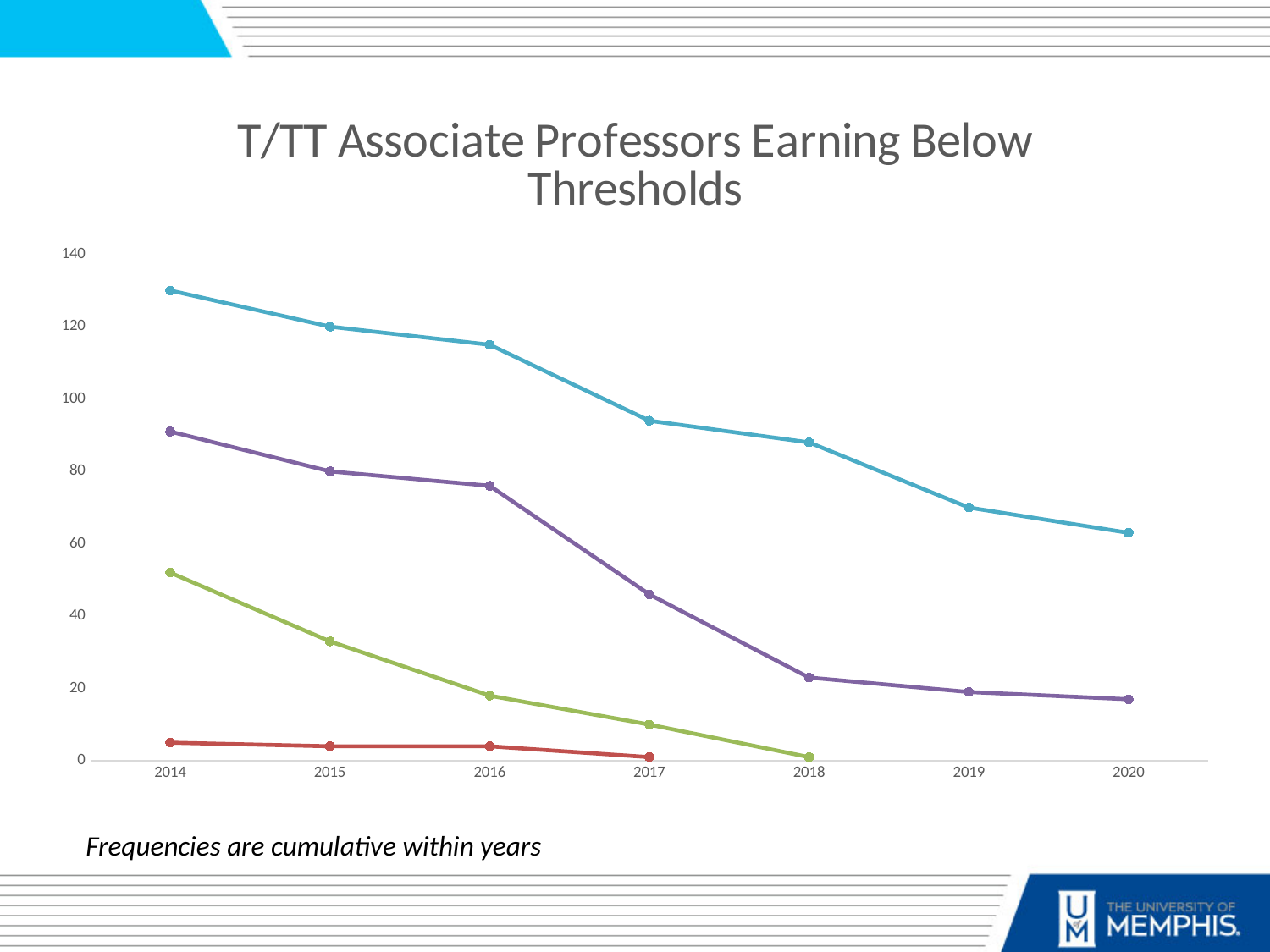
How many years are shown on the x axis of the chart? 7 Does the blue line rise or fall from 2014 to 2020? fall How many lines are plotted on the chart? 4 What kind of chart is shown on the slide? line chart Is the value of the green line in 2014 greater or less than 40? greater In 2014, which line has the higher value, the blue line or the purple line? the blue line Does the purple line rise or fall from 2014 to 2020? fall Is the value of the blue line in 2017 greater or less than 100? less Is the value of the blue line in 2014 greater or less than 120? greater What is the title of the chart? T/TT Associate Professors Earning Below Thresholds